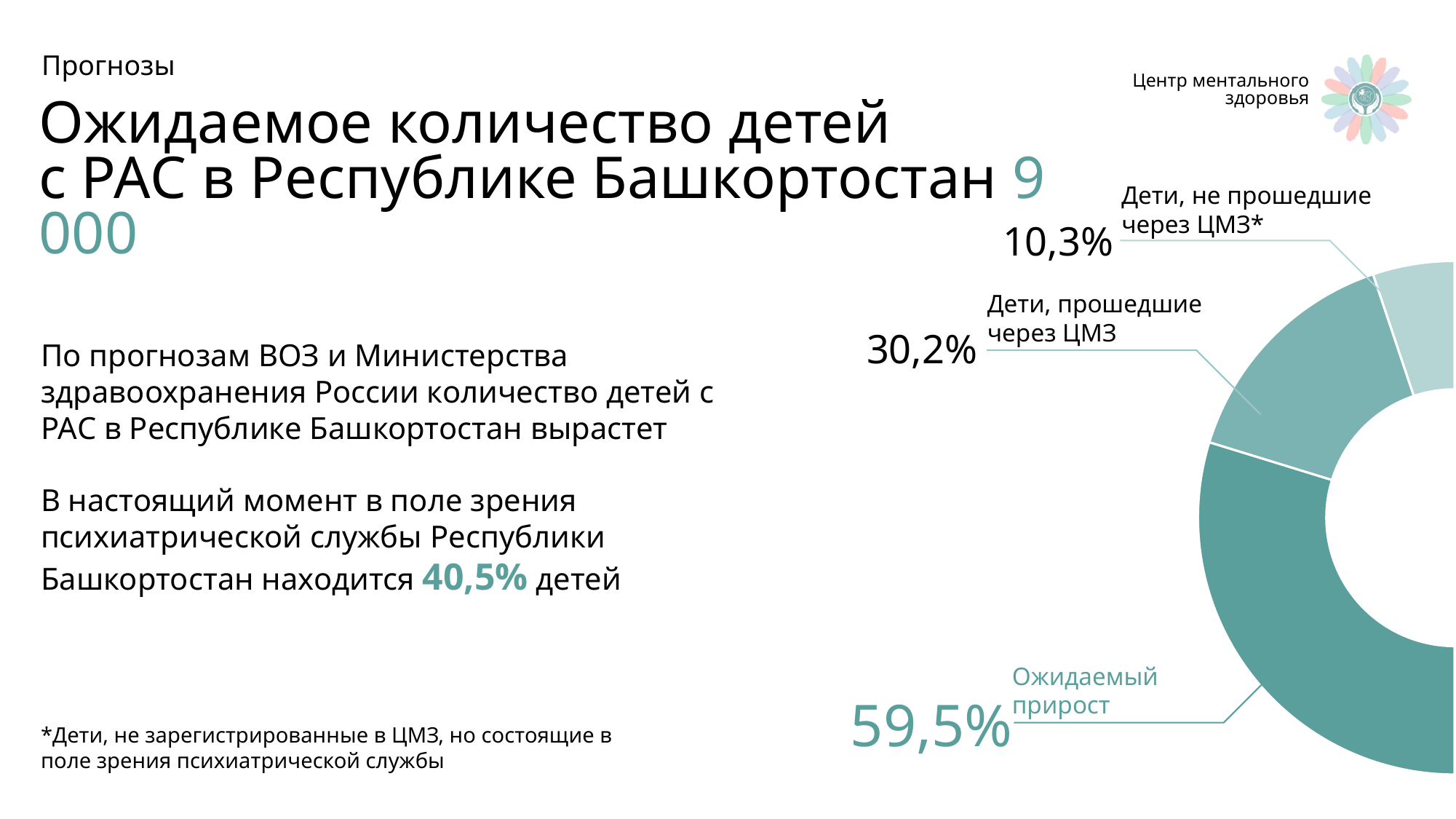
What is the combined share of the two slices about children who have and have not passed through ЦМЗ? 40,5% How many slices does the donut chart have? 3 Which slice of the chart is the smallest? Дети, не прошедшие через ЦМЗ* What kind of chart is shown on the slide? Pie (donut) chart What is the difference in percentage points between "Ожидаемый прирост" and "Дети, прошедшие через ЦМЗ"? 29,3 Which is larger: the share for "Дети, прошедшие через ЦМЗ" or the share for "Дети, не прошедшие через ЦМЗ*"? Дети, прошедшие через ЦМЗ Which slice of the chart is the largest? Ожидаемый прирост What share of the chart is labelled "Ожидаемый прирост"? 59,5% What share of the chart is labelled "Дети, прошедшие через ЦМЗ"? 30,2% What is the difference in percentage points between "Дети, прошедшие через ЦМЗ" and "Дети, не прошедшие через ЦМЗ*"? 19,9 Which slice of the chart is drawn in the darkest teal colour? Ожидаемый прирост What share of the chart is labelled "Дети, не прошедшие через ЦМЗ*"? 10,3%